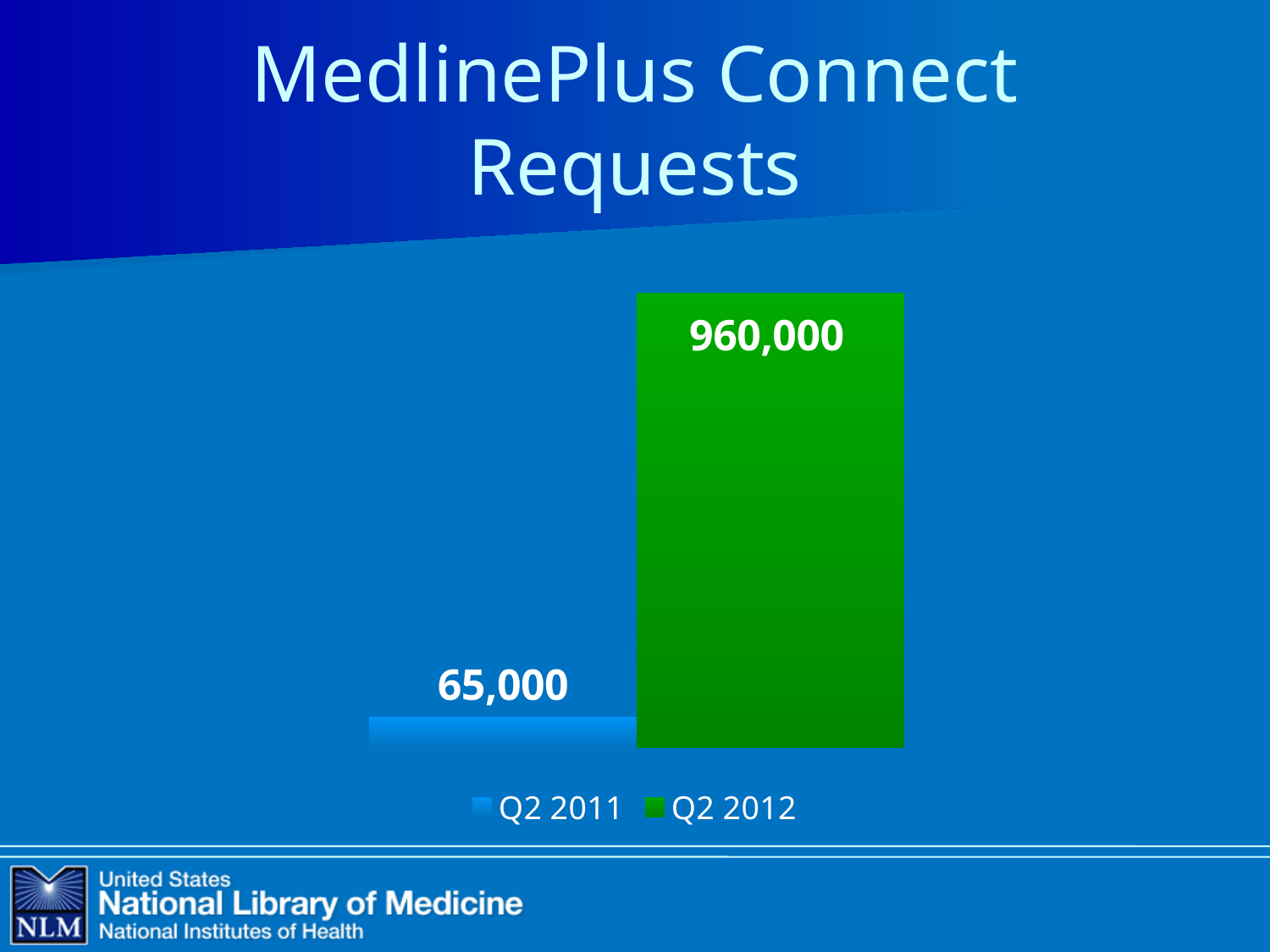
What is the value for Q2 2011? 65,000 What colour is the bar for Q2 2012? green How many bars are plotted on the chart? 2 What is the difference between the Q2 2012 and Q2 2011 values? 895,000 Do the values rise or fall from Q2 2011 to Q2 2012? rise What is the title of the slide containing the chart? MedlinePlus Connect Requests What is the value for Q2 2012? 960,000 Which is larger, the value for Q2 2011 or the value for Q2 2012? Q2 2012 Which series has the highest value? Q2 2012 What kind of chart is shown on the slide? bar chart Which series has the lowest value? Q2 2011 How many series does the legend list? 2